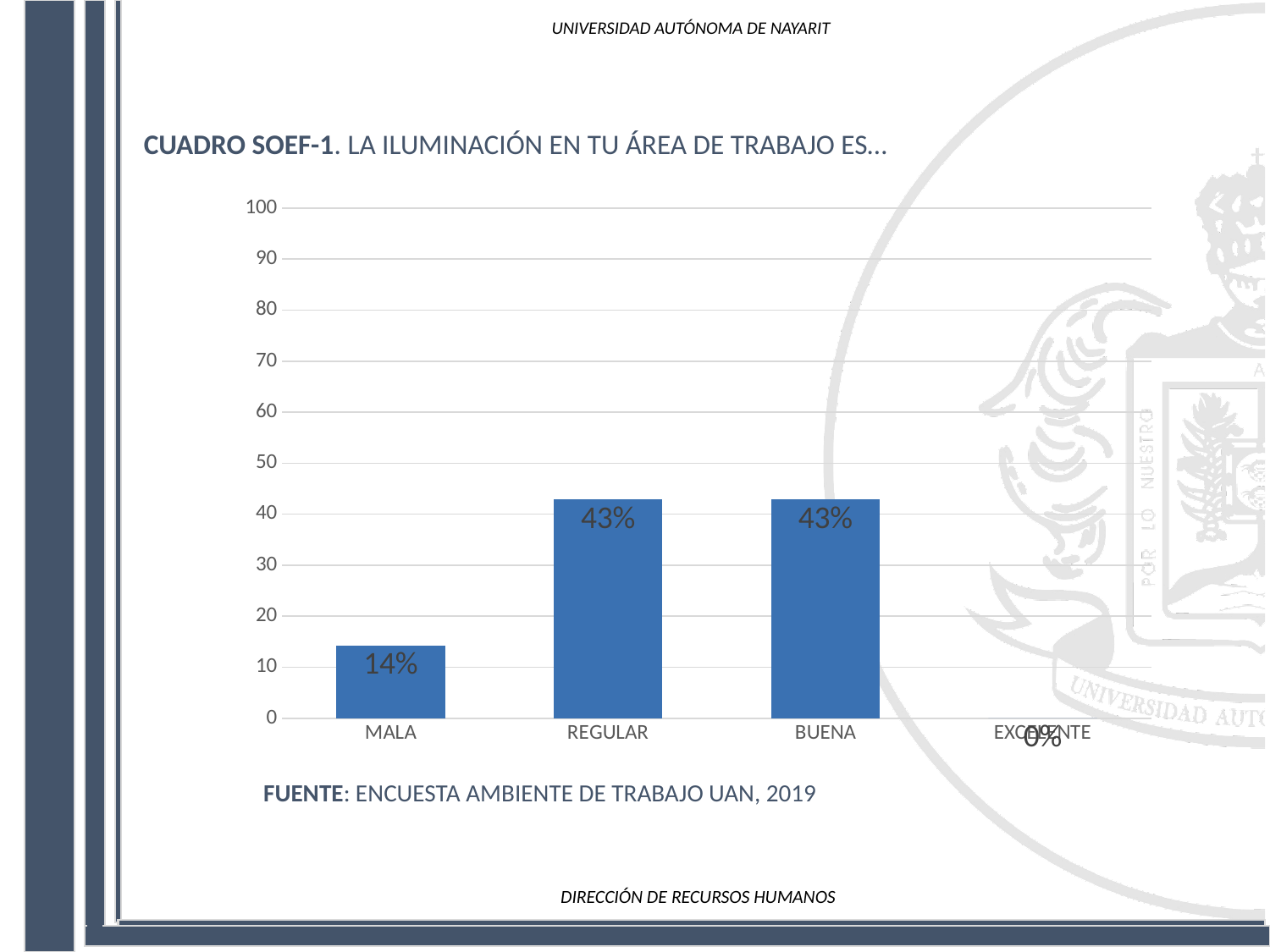
How many categories are shown on the x axis? 4 Is the value for MALA greater or less than 20? less What is the difference between the value for BUENA and the value for MALA? 29 percentage points Is the value for REGULAR greater or less than 40? greater Which category has the lowest value? EXCELENTE Which is larger, the value for MALA or the value for REGULAR? REGULAR What is the source cited below the chart? ENCUESTA AMBIENTE DE TRABAJO UAN, 2019 What kind of chart is shown on the slide? bar chart What is the value for BUENA? 43% What is the value for MALA? 14% What is the value for EXCELENTE? 0% What is the value for REGULAR? 43%